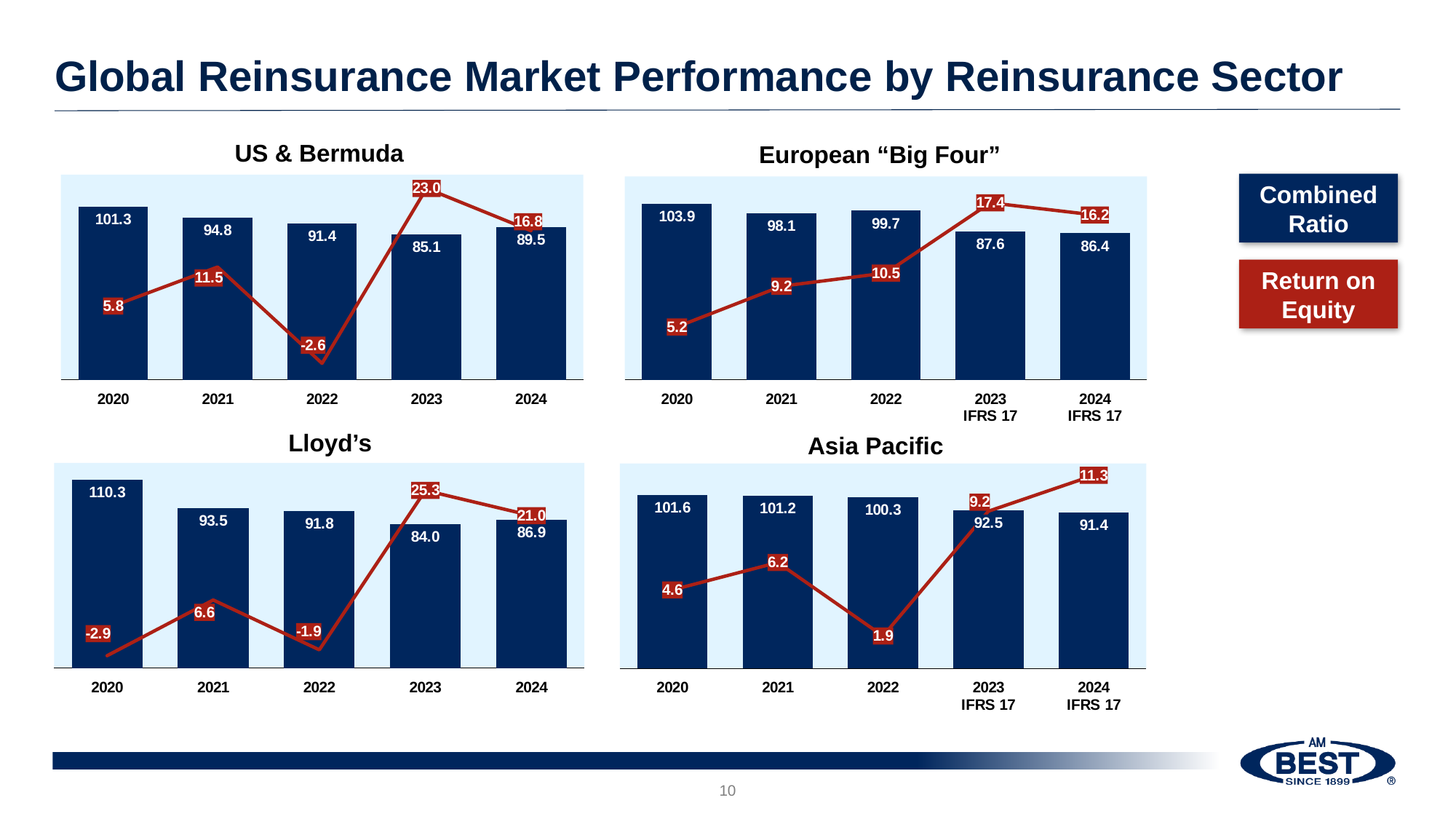
In the Lloyd's chart, which year has the highest Combined Ratio? 2020 In the European "Big Four" chart, what is the Return on Equity for 2023 IFRS 17? 17.4 In the Lloyd's chart, what is the Return on Equity for 2020? -2.9 In the Asia Pacific chart, which is larger, the Return on Equity in 2021 or in 2022? 2021 In the European "Big Four" chart, does the Return on Equity rise or fall from 2020 to 2023 IFRS 17? Rise In the European "Big Four" chart, what is the difference between the Combined Ratio in 2020 and in 2024 IFRS 17? 17.5 In the US & Bermuda chart, which year has the lowest Return on Equity? 2022 How many series does the legend on the slide list? 2 What kind of chart is the Asia Pacific chart? Combined bar and line chart In the US & Bermuda chart, what is the Combined Ratio for 2022? 91.4 In the Asia Pacific chart, what is the Combined Ratio for 2024 IFRS 17? 91.4 How many years are shown on the x axis of the Lloyd's chart? 5